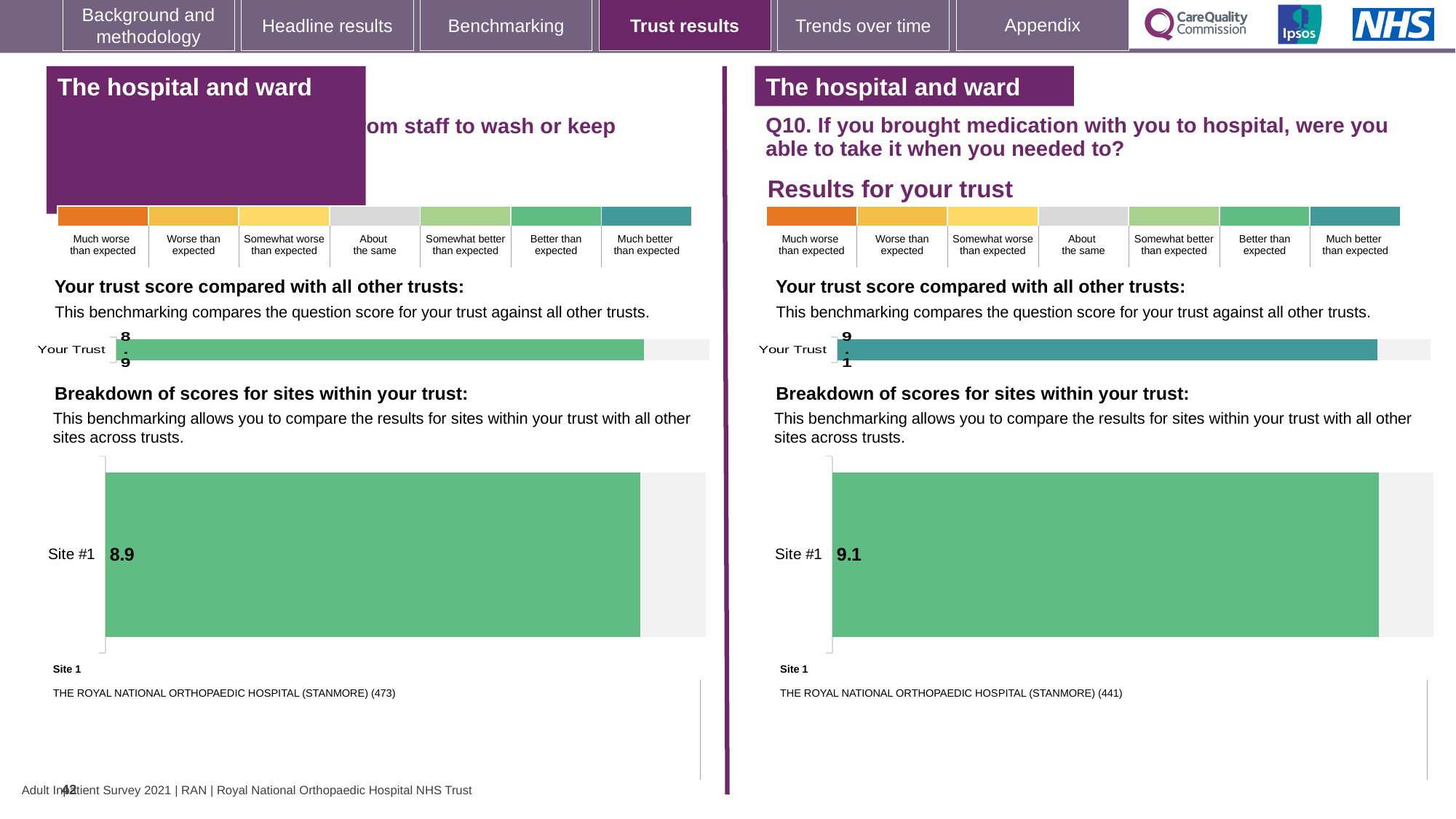
Which is larger: the Site #1 score in the left breakdown chart or the Site #1 score in the right (Q10) breakdown chart? The right (Q10) chart, 9.1 On the right half of the slide (Q10), what is the score shown for Your Trust in the 'Your trust score compared with all other trusts' chart? 9.1 Which site name is listed as Site 1 under the right (Q10) breakdown chart? THE ROYAL NATIONAL ORTHOPAEDIC HOSPITAL (STANMORE) (441) What kind of chart is used to show the Site #1 score on the right half of the slide? Bar chart In the right 'Breakdown of scores for sites within your trust' chart (Q10), what is the value for Site #1? 9.1 How many sites are shown in the right (Q10) 'Breakdown of scores for sites within your trust' chart? 1 How many benchmark categories are shown in the colour key above the Q10 'Your trust score compared with all other trusts' chart? 7 What kind of chart is used to show the Your Trust score on the left half of the slide? Bar chart On the left half of the slide, what is the score shown for Your Trust in the 'Your trust score compared with all other trusts' chart? 8.9 What is the difference between the Site #1 score in the right (Q10) breakdown chart and the Site #1 score in the left breakdown chart? 0.2 In the left 'Breakdown of scores for sites within your trust' chart, what is the value for Site #1? 8.9 How many sites are shown in the left 'Breakdown of scores for sites within your trust' chart? 1